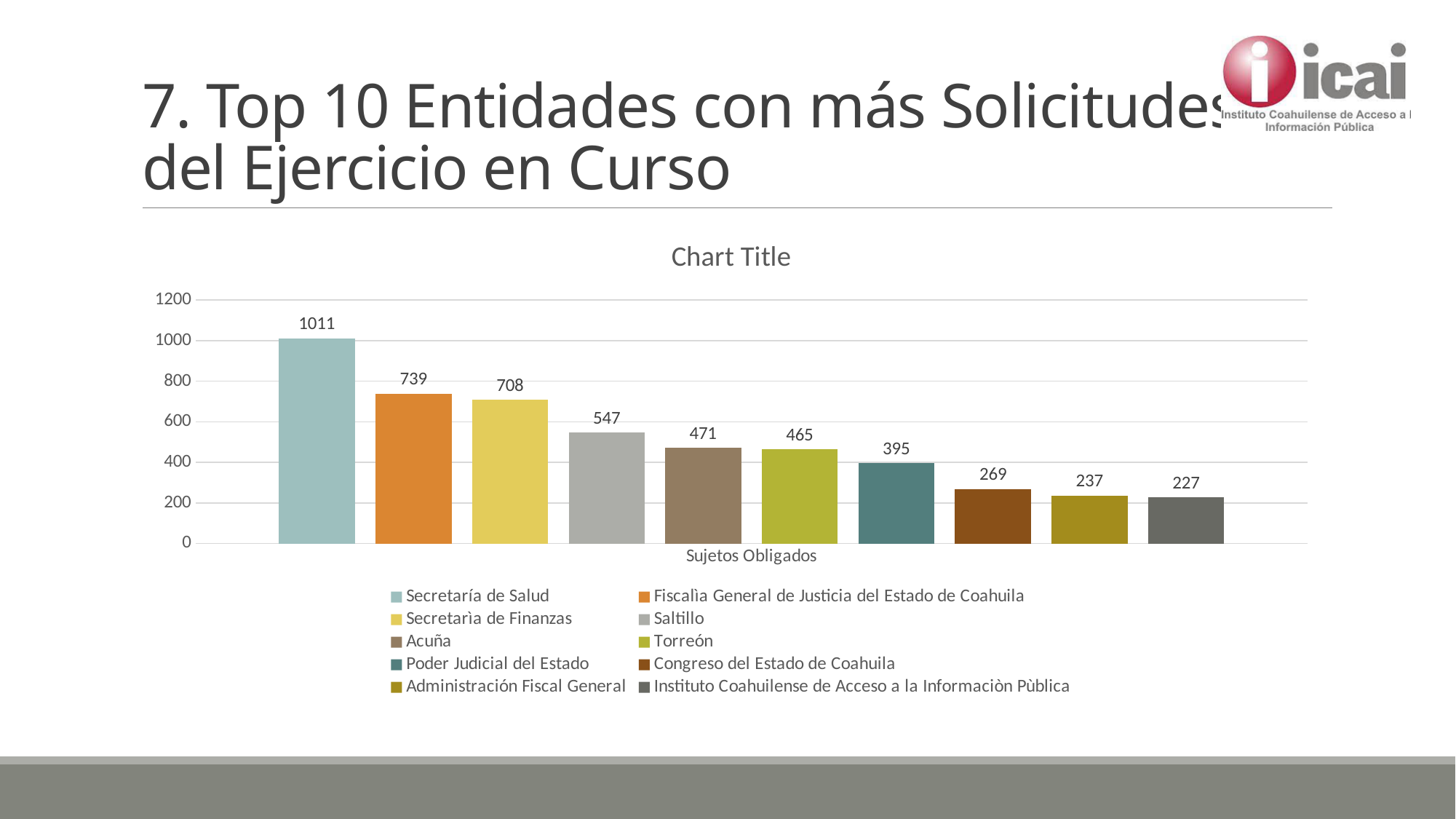
Is the value for Secretaría de Finanzas greater or less than 600? greater What is the difference between the values for Secretaría de Salud and Fiscalía General de Justicia del Estado de Coahuila? 272 What value is shown for Secretaría de Salud? 1011 What value is shown for Instituto Coahuilense de Acceso a la Información Pública? 227 Which entity has the lowest value in the chart? Instituto Coahuilense de Acceso a la Información Pública Which entity has the highest value in the chart? Secretaría de Salud What is the difference between the values for Acuña and Torreón? 6 What value is shown for Poder Judicial del Estado? 395 What kind of chart is shown on the slide? Bar chart What value is shown for Saltillo? 547 Which has a larger value, Saltillo or Congreso del Estado de Coahuila? Saltillo How many series does the legend list? 10